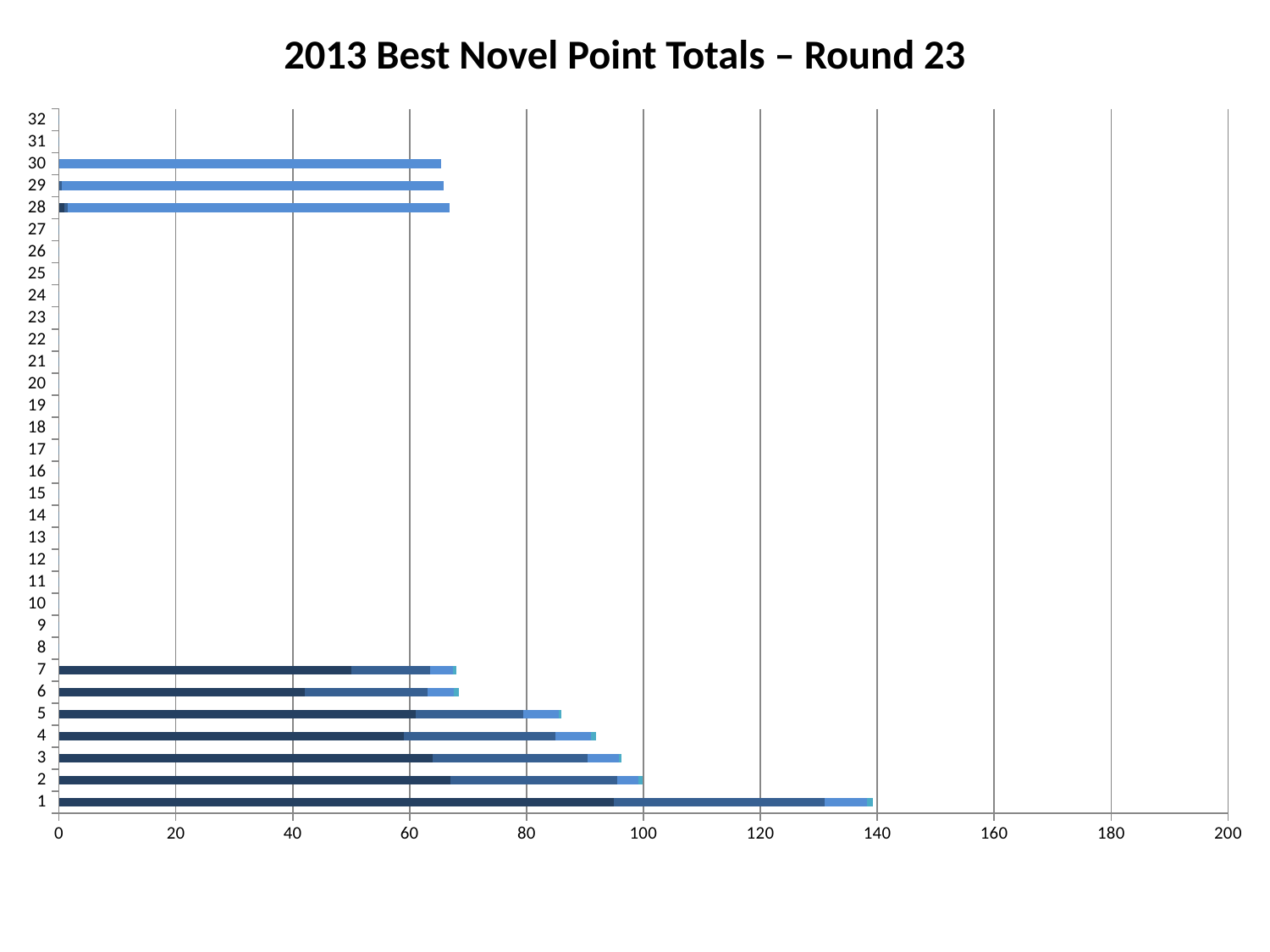
Which category has the longest bar? 1 Is the total value for category 1 greater or less than 120? greater Which has the larger total, category 3 or category 5? 3 What is the highest value shown on the horizontal axis? 200 Is the total value for category 7 greater or less than 80? less What kind of chart is shown on the slide? bar chart How many categories are listed on the vertical axis? 32 Is the total value for category 28 greater or less than 60? greater What is the title of the chart? 2013 Best Novel Point Totals – Round 23 Which has the larger total, category 1 or category 2? 1 How many categories have a visible bar plotted? 10